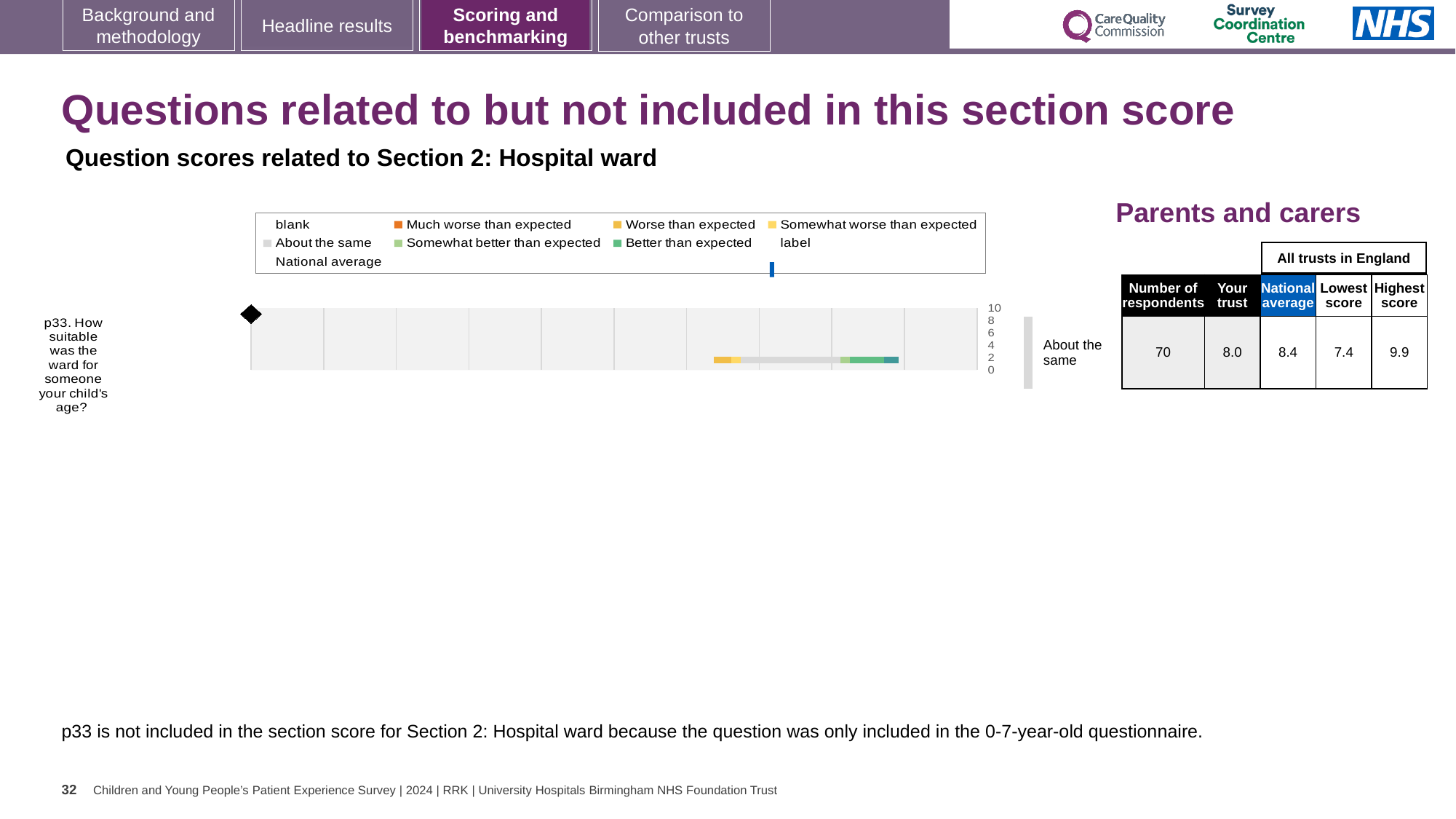
For p33, what is the difference between the highest score and the lowest score among all trusts in England? 2.5 What benchmark category is shown next to the bar for p33? About the same In the Parents and carers table, what is the national average score for p33? 8.4 In the Parents and carers table, what is the lowest score among all trusts in England for p33? 7.4 For p33, how much higher is the national average than the 'Your trust' score? 0.4 How many questions are plotted in the chart? 1 What is the highest tick value shown on the chart's score axis? 10 In the Parents and carers table, what is the 'Your trust' score for p33? 8.0 How many respondents answered p33 according to the Parents and carers table? 70 For p33, which is larger: the 'Your trust' score or the national average? National average In the Parents and carers table, what is the highest score among all trusts in England for p33? 9.9 What kind of chart is used to show the p33 question score? bar chart